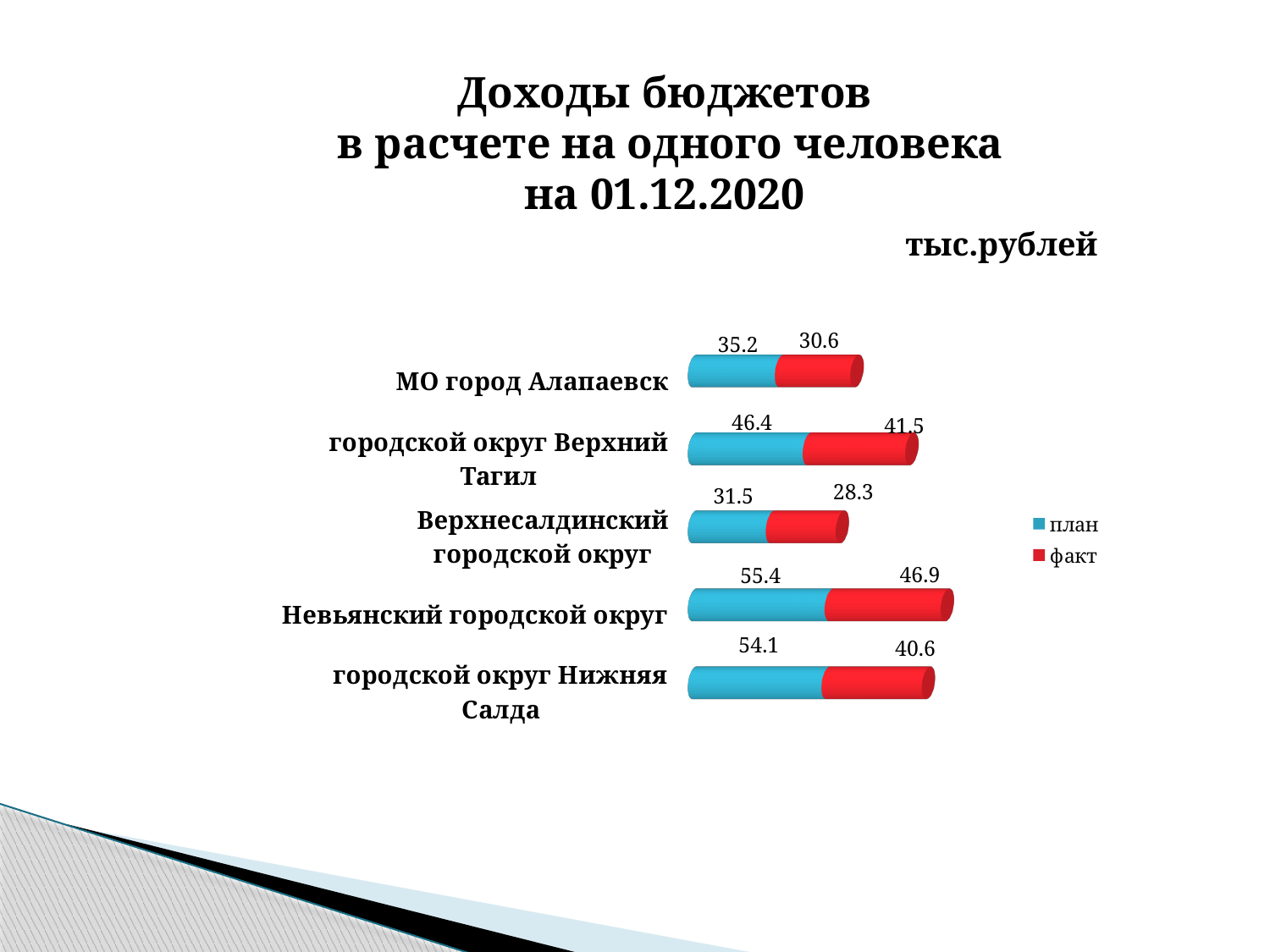
What is the total of the stacked bar for Верхнесалдинский городской округ? 59.8 How many categories are shown in the chart? 5 What kind of chart is shown on the slide? Bar chart Which category has the highest план value? Невьянский городской округ What is the difference between the план and факт values for городской округ Нижняя Салда? 13.5 What unit is stated for the values in the chart? тыс.рублей How many series does the legend list? 2 What is the факт value for МО город Алапаевск? 30.6 What is the факт value for городской округ Нижняя Салда? 40.6 What is the план value for Невьянский городской округ? 55.4 Which is larger: the факт value for городской округ Верхний Тагил or the факт value for Невьянский городской округ? Невьянский городской округ Which category has the lowest факт value? Верхнесалдинский городской округ